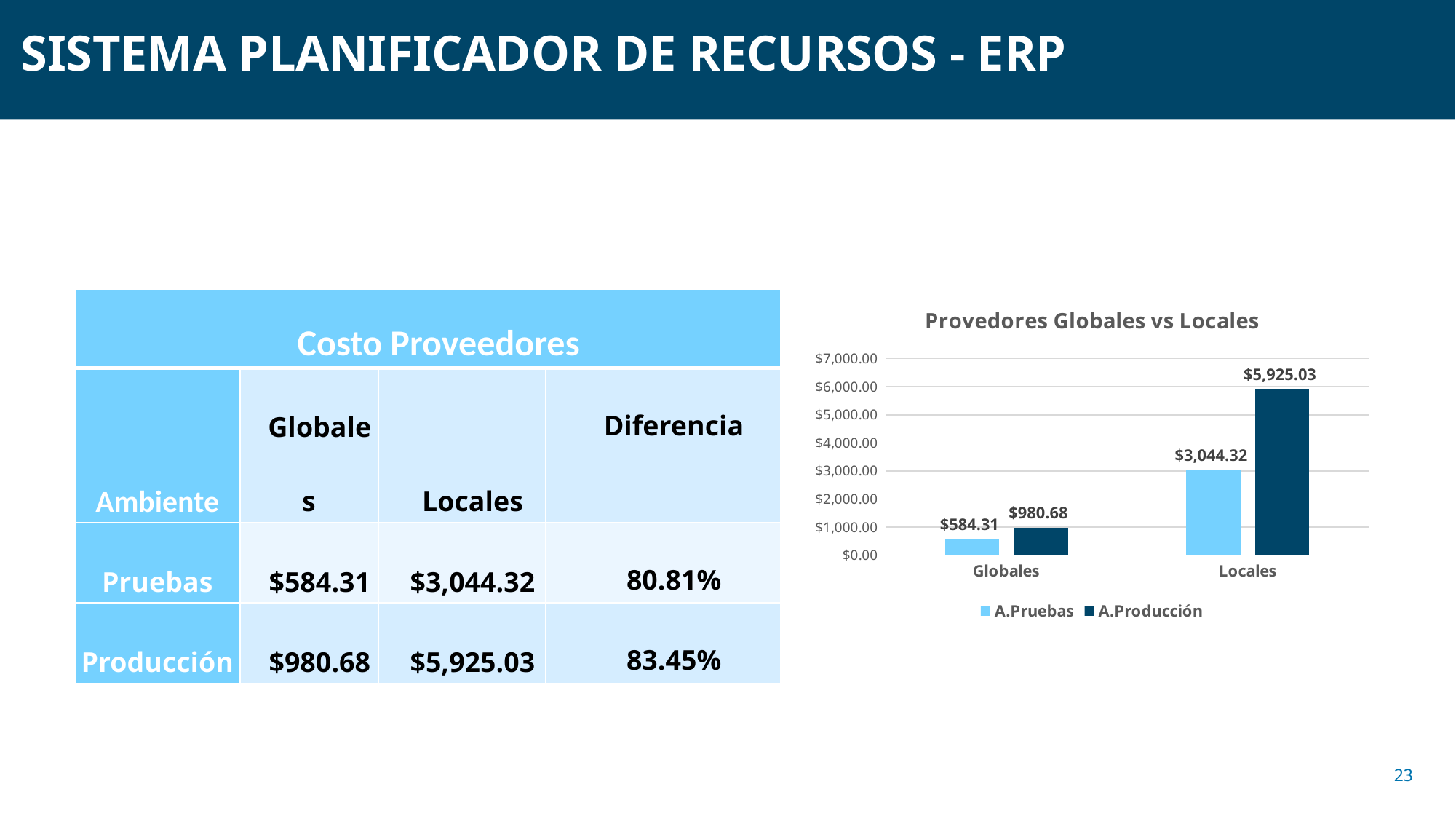
What is the value of A.Producción for Locales? $5,925.03 How many series does the legend list? 2 What is the value of A.Pruebas for Locales? $3,044.32 Which category has the lowest A.Pruebas value? Globales What is the value of A.Pruebas for Globales? $584.31 What is the value of A.Producción for Globales? $980.68 How many categories are shown on the x axis? 2 Which category has the highest A.Producción value? Locales What kind of chart is shown? Bar chart What is the title of the chart? Provedores Globales vs Locales Which is larger: A.Pruebas for Locales or A.Producción for Globales? A.Pruebas for Locales What is the difference between the A.Producción and A.Pruebas values for Locales? $2,880.71